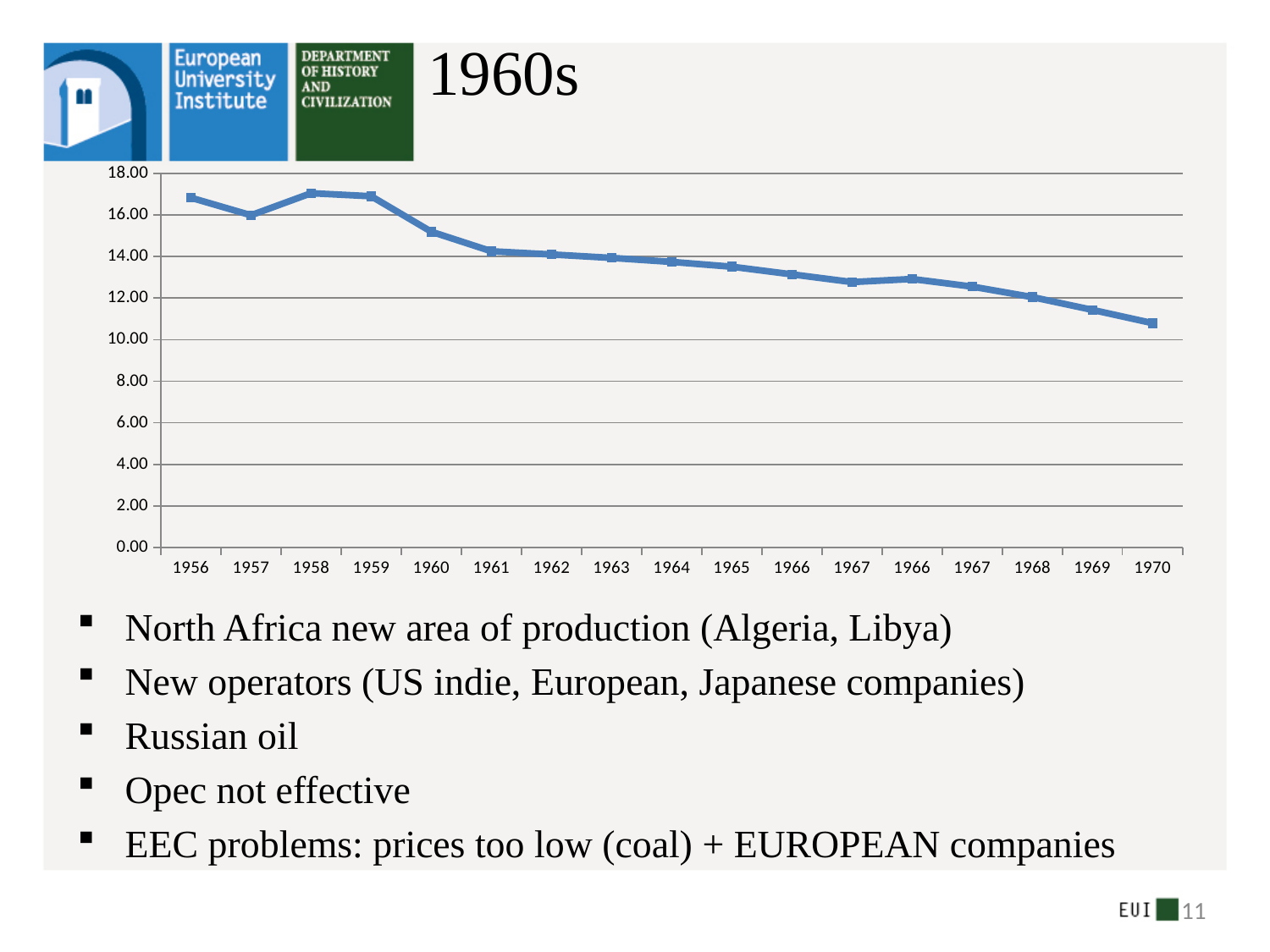
What kind of chart is shown on the slide? line chart Which is larger, the value for 1960 or the value for 1965? 1960 Is the value for 1960 greater or less than 14.00? greater Is the value for 1965 greater or less than 14.00? less How many data points are plotted on the line? 17 Which is larger, the value for 1956 or the value for 1970? 1956 Is the value for 1969 greater or less than 12.00? less Do the values generally rise or fall from 1956 to 1970? fall Which year has the lowest value on the chart? 1970 What is the highest value shown on the y axis? 18.00